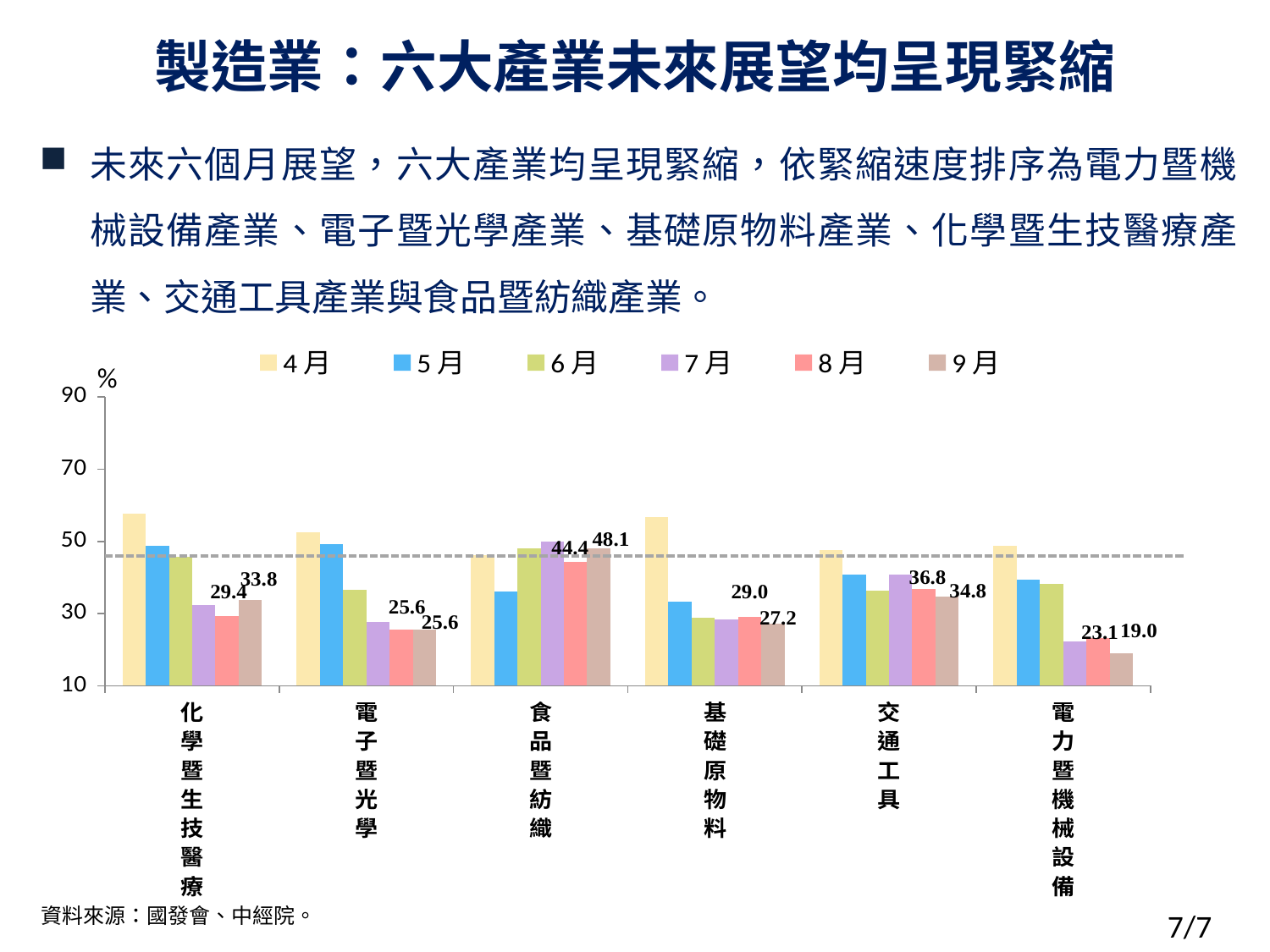
What is the difference between the 9月 and 8月 values for 食品暨紡織? 3.7 What is the 9月 value for 化學暨生技醫療? 33.8 Is the 4月 value for 化學暨生技醫療 greater or less than 50? greater What kind of chart is shown on the slide? bar chart Which industry has the lowest 9月 value? 電力暨機械設備 How many industries are shown on the x axis? 6 What is the 9月 value for 食品暨紡織? 48.1 How many series does the legend list? 6 Which industry has the highest 9月 value? 食品暨紡織 Which is larger for 基礎原物料, the 8月 value or the 9月 value? 8月 What is the 8月 value for 電力暨機械設備? 23.1 What is the 8月 value for 交通工具? 36.8